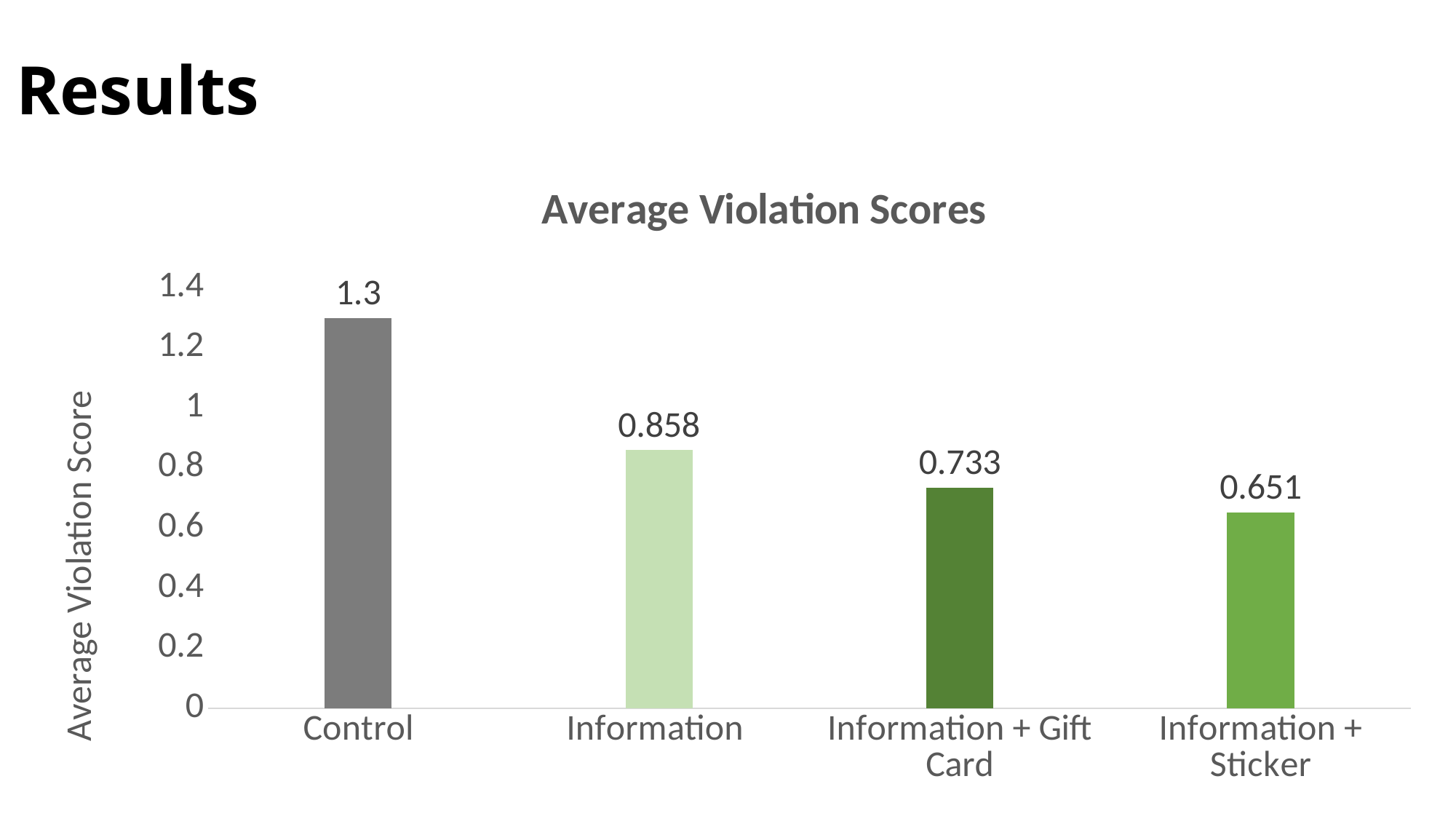
What kind of chart is shown on the slide? Bar chart What is the average violation score for the Information + Sticker group? 0.651 What is the difference between the average violation scores of the Control and Information groups? 0.442 Which group has the lowest average violation score? Information + Sticker What is the average violation score for the Information + Gift Card group? 0.733 Which has a higher average violation score, Information or Information + Gift Card? Information What is the average violation score for the Control group? 1.3 Which group has the highest average violation score? Control What is the difference between the average violation scores of the Information + Gift Card and Information + Sticker groups? 0.082 How many groups are shown in the chart? 4 Is the value for Information + Sticker greater or less than 0.8? less What is the title of the chart? Average Violation Scores